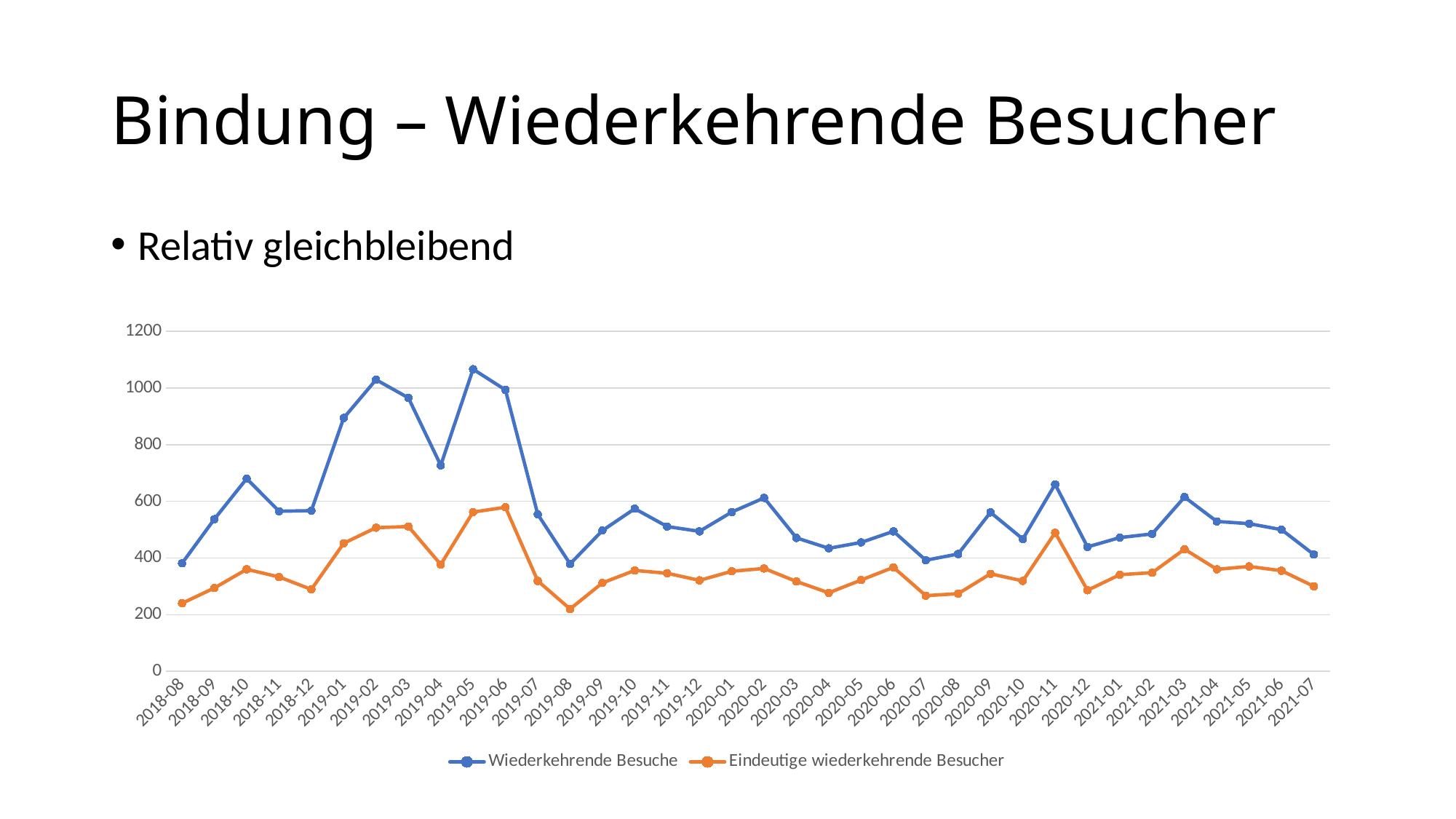
Is the value for Wiederkehrende Besuche in 2019-04 greater or less than 800? less How many series does the legend list? 2 Which is larger for Eindeutige wiederkehrende Besucher: the value in 2020-11 or the value in 2020-12? 2020-11 Which is larger for Wiederkehrende Besuche: the value in 2019-05 or the value in 2019-04? 2019-05 In which month does the Wiederkehrende Besuche series reach its highest value? 2019-05 Is the value for Eindeutige wiederkehrende Besucher in 2020-11 greater or less than 400? greater Is the value for Wiederkehrende Besuche in 2019-05 greater or less than 1000? greater How many months are plotted along the x axis? 36 Which colour is used for the Wiederkehrende Besuche series? Blue Do the values for Wiederkehrende Besuche rise or fall from 2019-06 to 2019-08? fall What kind of chart is shown on the slide? Line chart